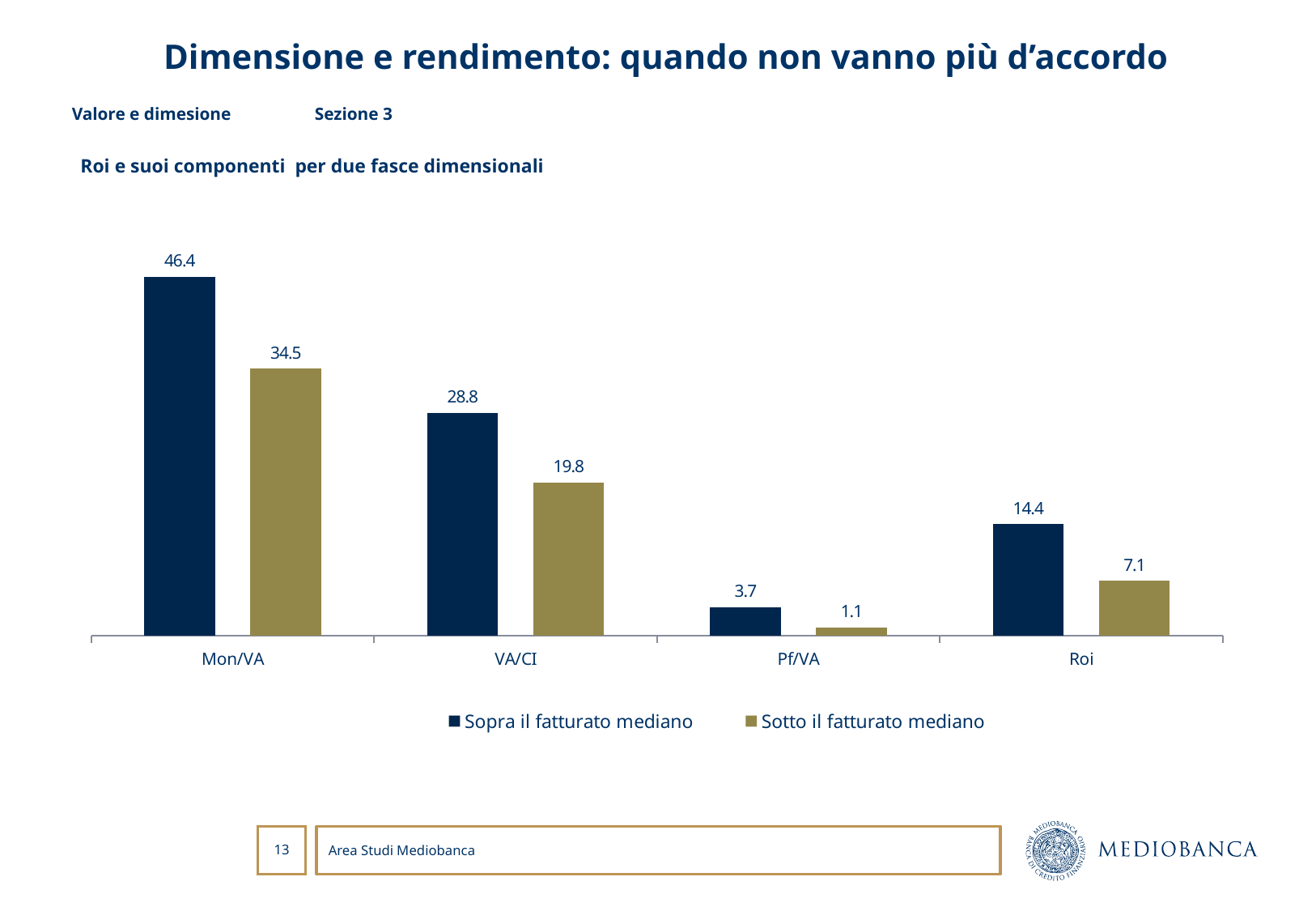
What kind of chart is shown on the slide? Bar chart What is the value for VA/CI in the 'Sotto il fatturato mediano' series? 19.8 What is the difference between the 'Sopra il fatturato mediano' and 'Sotto il fatturato mediano' values for Roi? 7.3 What is the difference between the 'Sopra il fatturato mediano' and 'Sotto il fatturato mediano' values for Mon/VA? 11.9 Which category has the highest value in the 'Sopra il fatturato mediano' series? Mon/VA Which is larger: the 'Sotto il fatturato mediano' value for Mon/VA or the 'Sopra il fatturato mediano' value for VA/CI? Sotto il fatturato mediano for Mon/VA How many categories are shown on the x axis? 4 Which category has the lowest value in the 'Sotto il fatturato mediano' series? Pf/VA What is the value for Roi in the 'Sopra il fatturato mediano' series? 14.4 How many series does the legend list? 2 What is the value for Pf/VA in the 'Sotto il fatturato mediano' series? 1.1 What is the value for Mon/VA in the 'Sopra il fatturato mediano' series? 46.4